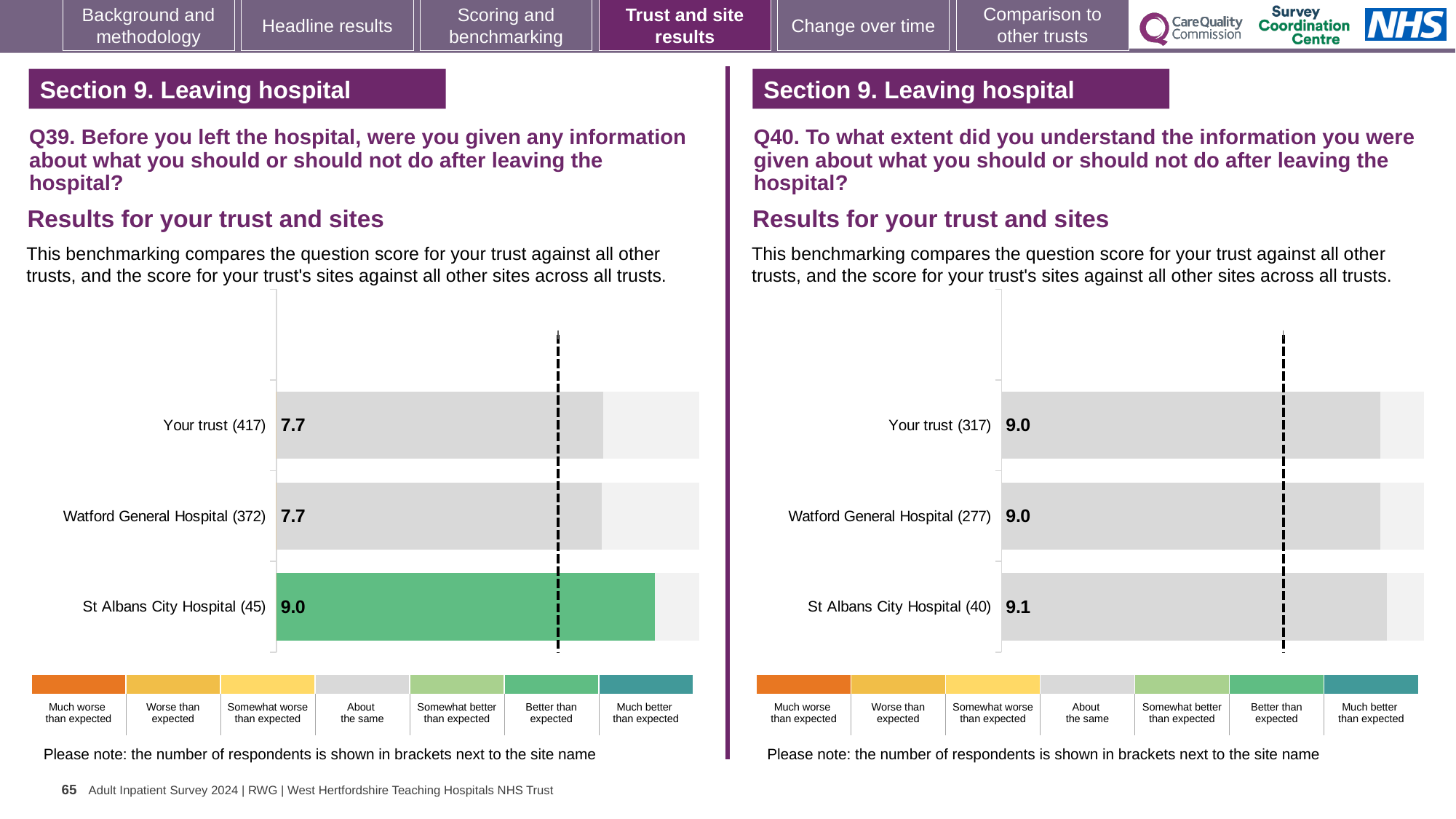
What kind of chart is used for the Q39 results on the left? Bar chart In the Q39 chart on the left, which site or trust has the highest score? St Albans City Hospital In the Q39 chart on the left, which benchmark category does the green colour of the St Albans City Hospital bar represent? Better than expected How many sites or trusts are plotted in the Q40 chart on the right? 3 In the Q39 chart on the left, what is the score for St Albans City Hospital? 9.0 In the Q39 chart on the left, which has the larger score, St Albans City Hospital or Watford General Hospital? St Albans City Hospital In the Q40 chart on the right, what is the difference between the scores for St Albans City Hospital and Watford General Hospital? 0.1 In the Q40 chart on the right, what is the score for St Albans City Hospital? 9.1 In the Q40 chart on the right, what is the score for Watford General Hospital? 9.0 In the Q39 chart on the left, what is the difference between the scores for St Albans City Hospital and Your trust? 1.3 In the Q39 chart on the left, what is the score for Your trust? 7.7 In the Q40 chart on the right, how many respondents are shown in brackets for Your trust? 317